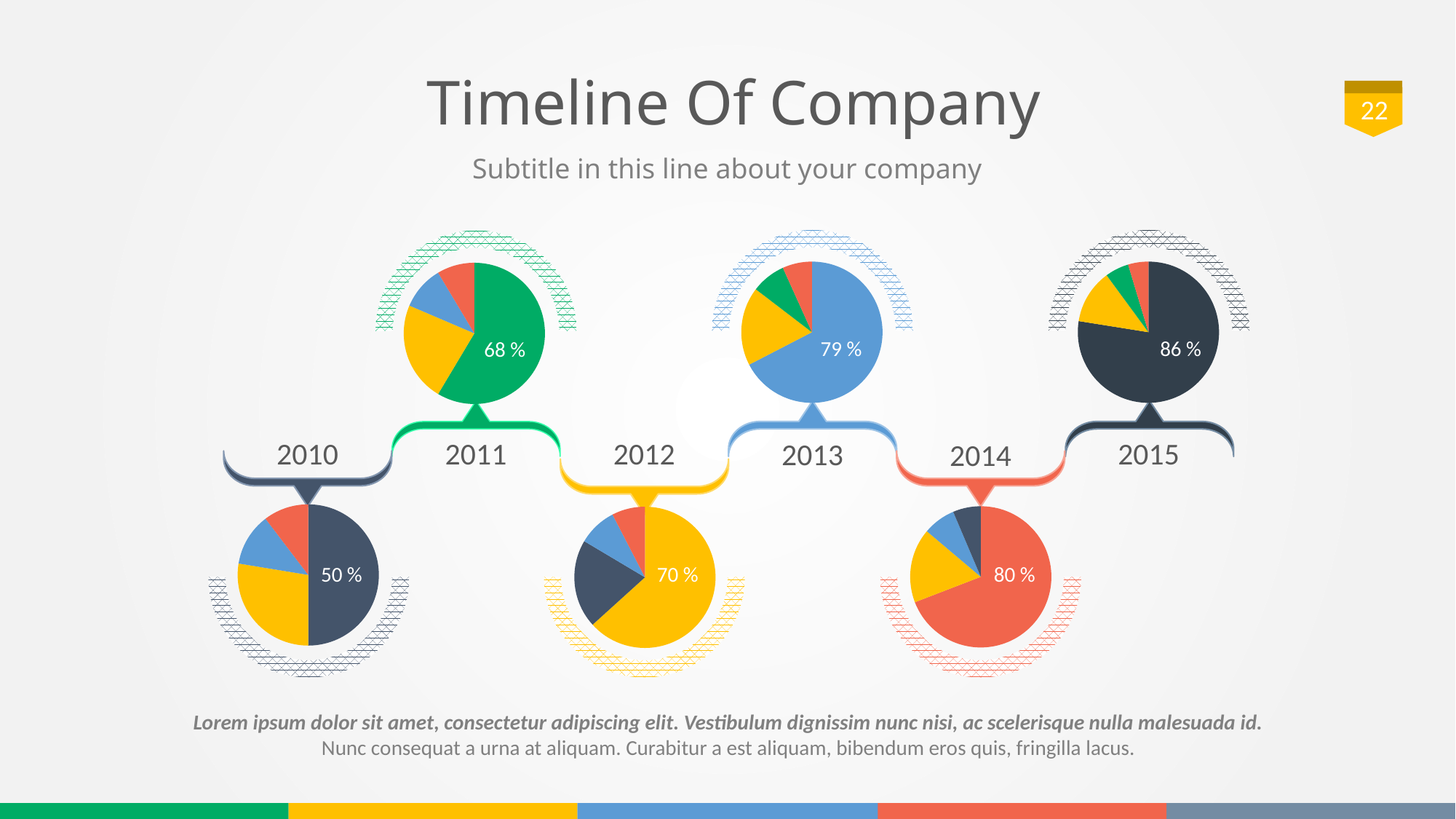
What colour is the largest slice of the 2014 pie chart? Red What percentage is labelled on the pie chart for 2011? 68 % Which year's pie chart shows the lowest labelled percentage? 2010 What percentage is labelled on the pie chart for 2010? 50 % What kind of charts are used on the timeline? Pie charts What percentage is labelled on the pie chart for 2015? 86 % How many pie charts are shown on the timeline? 6 What is the difference between the labelled percentage for 2015 and the labelled percentage for 2010? 36 % What percentage is labelled on the pie chart for 2013? 79 % Do the labelled percentages rise or fall from 2010 to 2015? Rise Which has the larger labelled percentage, the 2012 pie chart or the 2013 pie chart? 2013 Which year's pie chart shows the highest labelled percentage? 2015